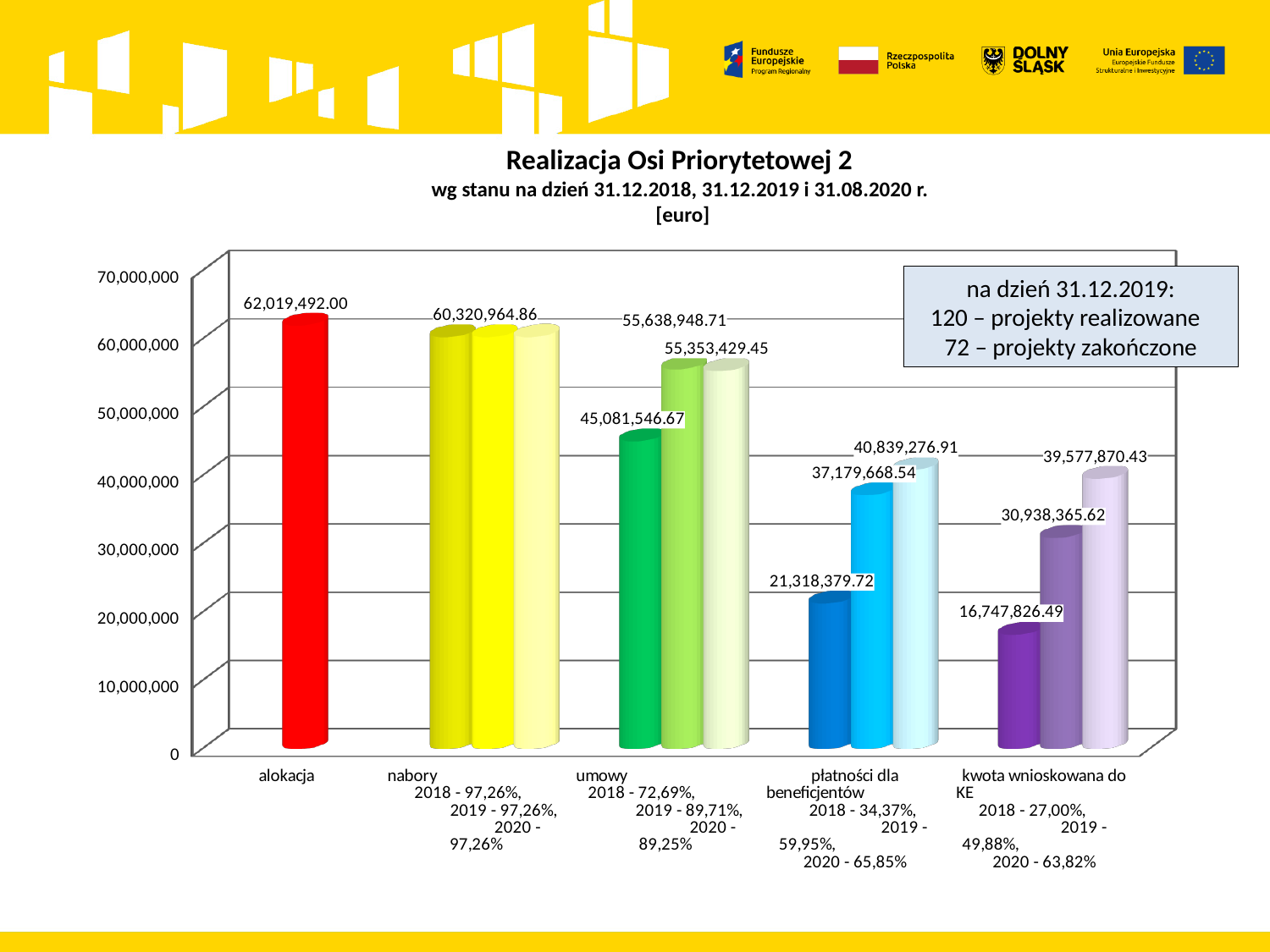
According to the text box on the chart, how many projects were being implemented (projekty realizowane) as of 31.12.2019? 120 What is the value of the tallest bar in the płatności dla beneficjentów category? 40,839,276.91 Which is larger: the tallest bar for płatności dla beneficjentów or the tallest bar for kwota wnioskowana do KE? płatności dla beneficjentów What type of chart is shown on the slide? bar chart What is the value of the shortest bar in the kwota wnioskowana do KE category? 16,747,826.49 Which category has the single highest bar on the chart? alokacja How many categories are shown on the x axis? 5 What is the value of the lowest bar in the umowy category? 45,081,546.67 What is the difference between the alokacja value (62,019,492.00) and the nabory value (60,320,964.86)? 1,698,527.14 What is the value of the alokacja bar? 62,019,492.00 What value is labelled on the nabory bars? 60,320,964.86 Which category contains the lowest bar on the chart? kwota wnioskowana do KE